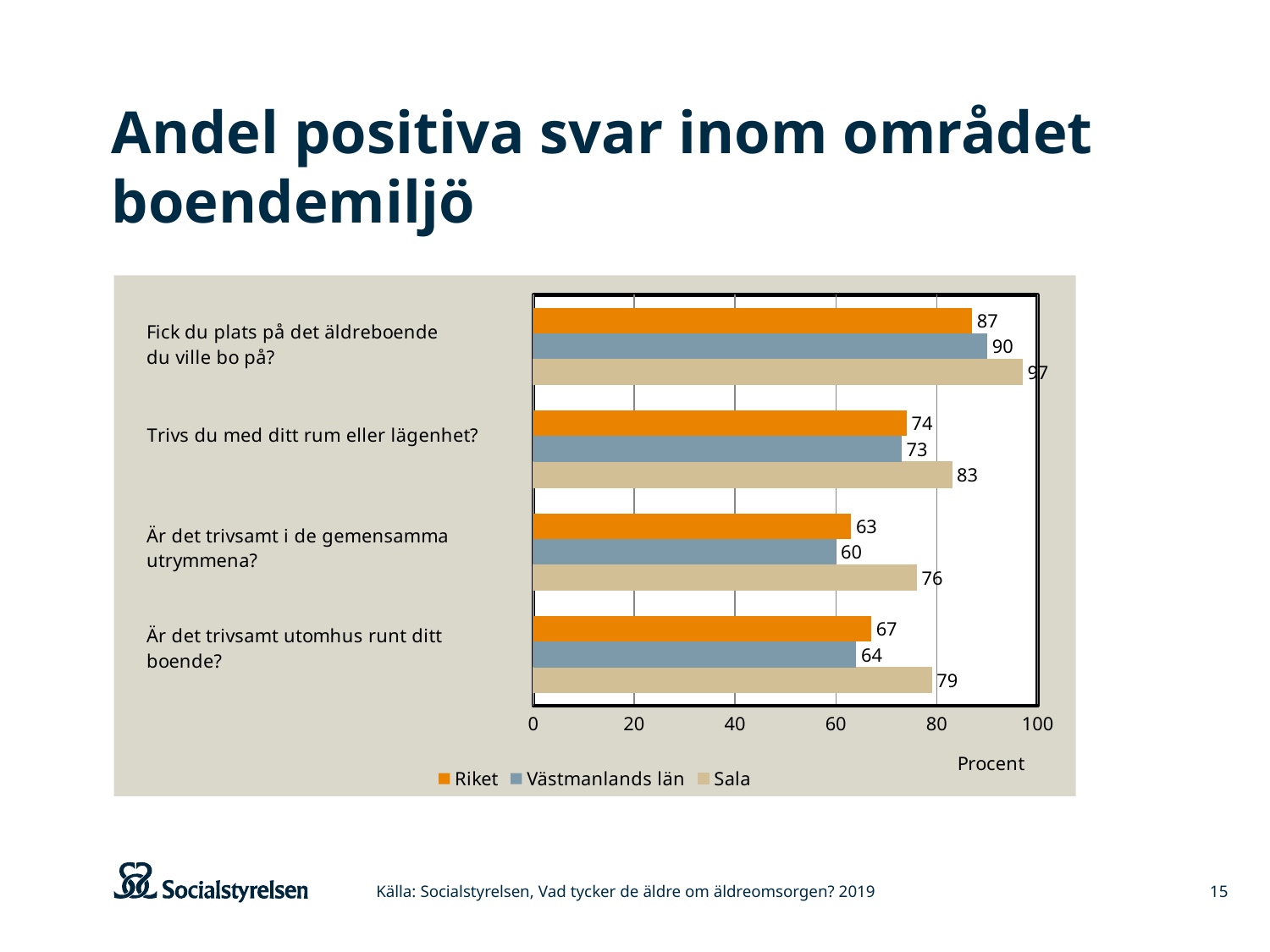
Which question has the lowest value for Riket? Är det trivsamt i de gemensamma utrymmena? What is the difference between Sala and Riket on "Är det trivsamt utomhus runt ditt boende?"? 12 What is the value for Västmanlands län on "Är det trivsamt i de gemensamma utrymmena?"? 60 What kind of chart is shown on the slide? Bar chart What is the label on the horizontal axis of the chart? Procent Is the value for Sala on "Är det trivsamt i de gemensamma utrymmena?" greater or less than 60? greater How many series does the legend list? 3 Which question has the highest value for Sala? Fick du plats på det äldreboende du ville bo på? How many questions (categories) are shown on the chart? 4 What is the value for Sala on "Fick du plats på det äldreboende du ville bo på?"? 97 What is the value for Riket on "Trivs du med ditt rum eller lägenhet?"? 74 Which is larger on "Trivs du med ditt rum eller lägenhet?": Riket or Västmanlands län? Riket